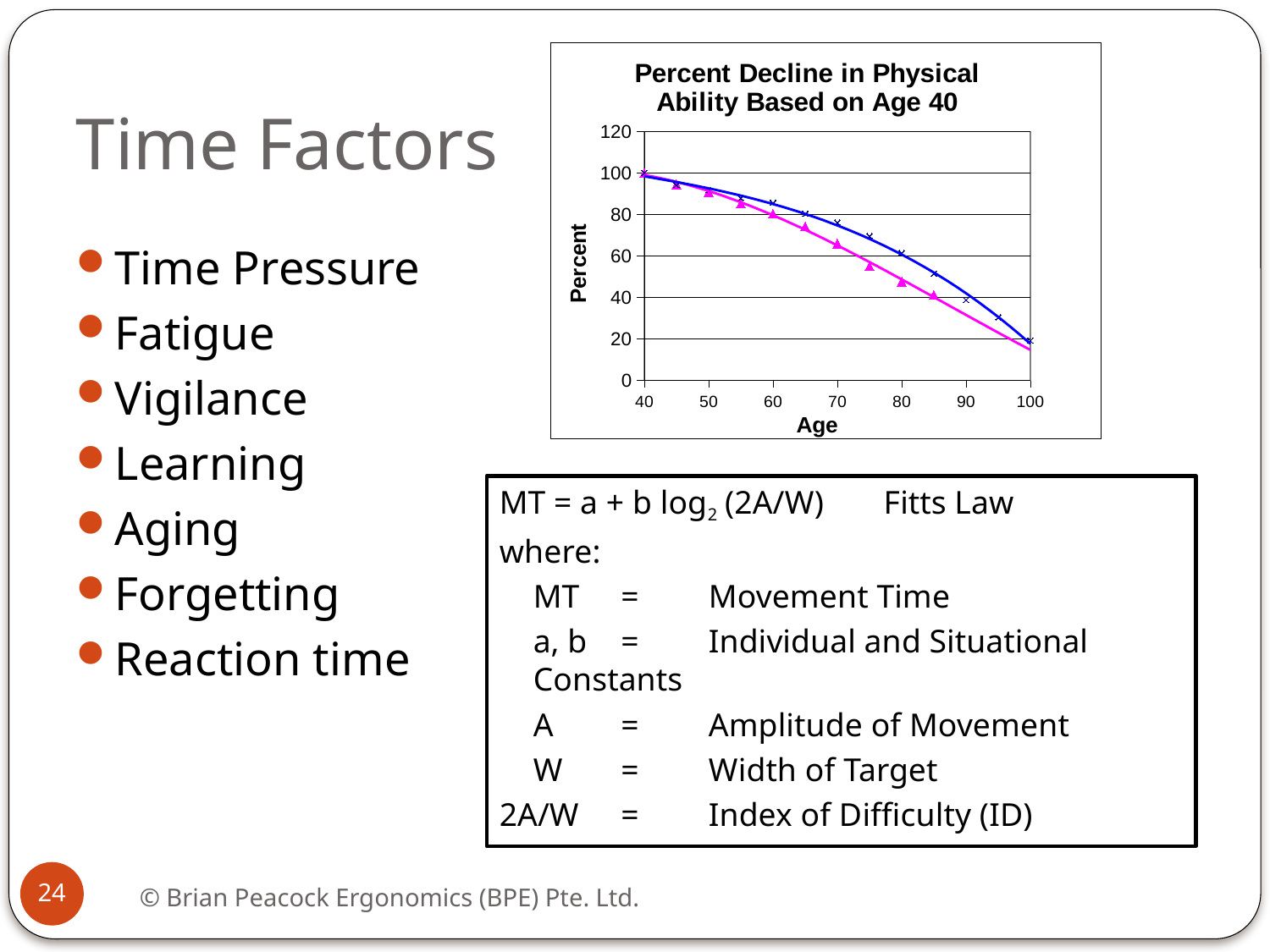
Is the value of the magenta line with triangle markers at age 80 greater or less than 60? less At age 80, which line is higher, the blue line with x markers or the magenta line with triangle markers? the blue line with x markers What is the value of the lines at age 40? 100 What is the label of the chart's x axis? Age At which age do both lines reach their highest value? 40 Is the value of the blue line with x markers at age 90 greater or less than 60? less How many age tick marks are labelled on the x axis? 7 What kind of chart is shown on the slide? line chart Do the plotted values rise or fall as age increases along the x axis? fall Is the value of the blue line with x markers at age 70 greater or less than 60? greater What is the title of the chart? Percent Decline in Physical Ability Based on Age 40